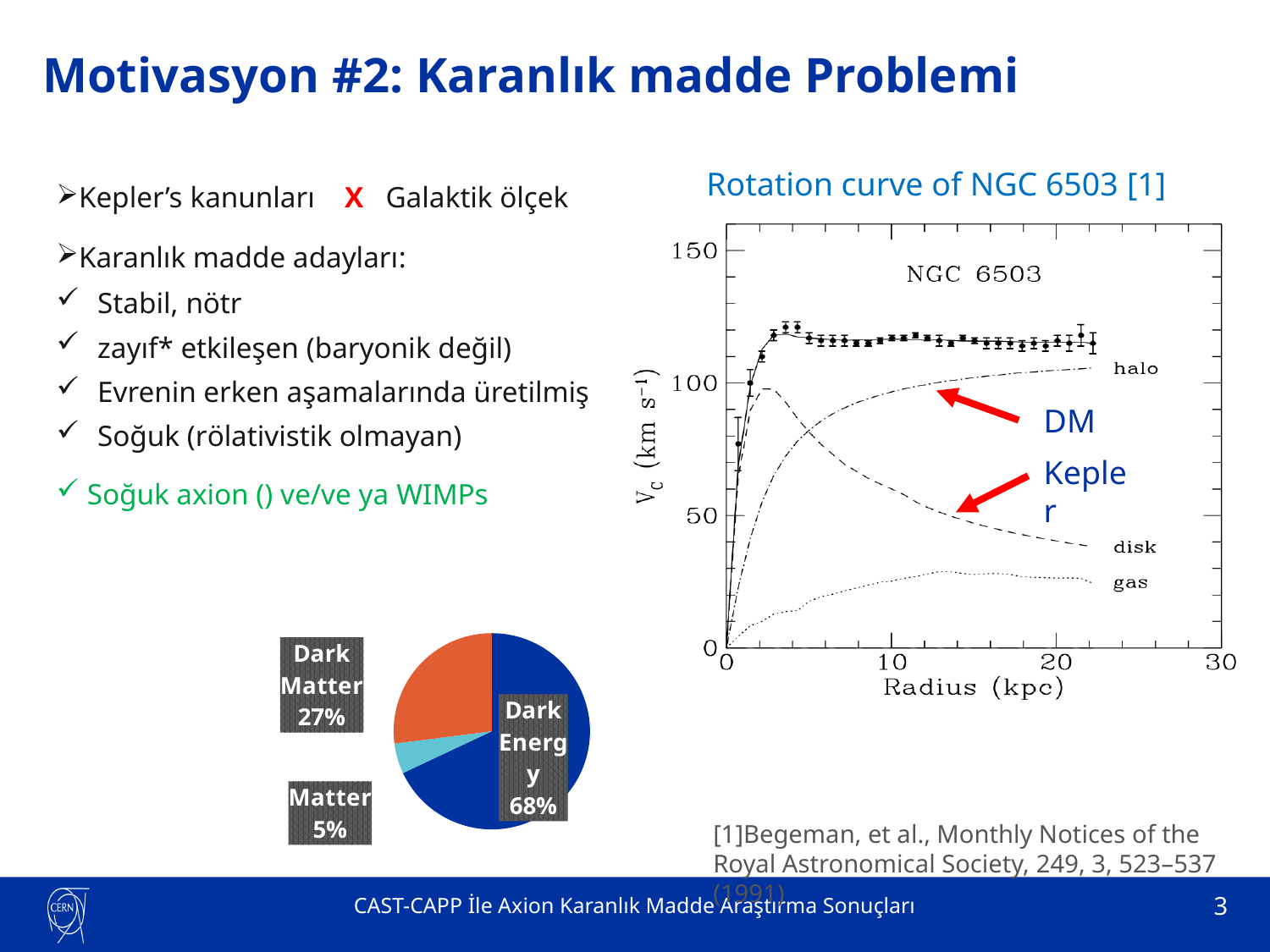
In the 'Rotation curve of NGC 6503' chart, how many labelled model curves (halo, disk, gas) are drawn? 3 In the pie chart, which component has the largest share? Dark Energy In the pie chart, what share is labelled for Matter? 5% How many slices does the pie chart have? 3 What kind of chart is the chart at the bottom left of the slide? Pie chart In the 'Rotation curve of NGC 6503' chart, is the value of the disk curve at a radius of 20 kpc greater or less than 50? less In the pie chart, what share is labelled for Dark Matter? 27% In the pie chart, which component has the smallest share? Matter In the 'Rotation curve of NGC 6503' chart, what is the label of the x axis? Radius (kpc) In the pie chart, what share is labelled for Dark Energy? 68% In the pie chart, which is larger, the Dark Matter share or the Matter share? Dark Matter In the pie chart, what is the difference between the Dark Energy share and the Dark Matter share? 41%